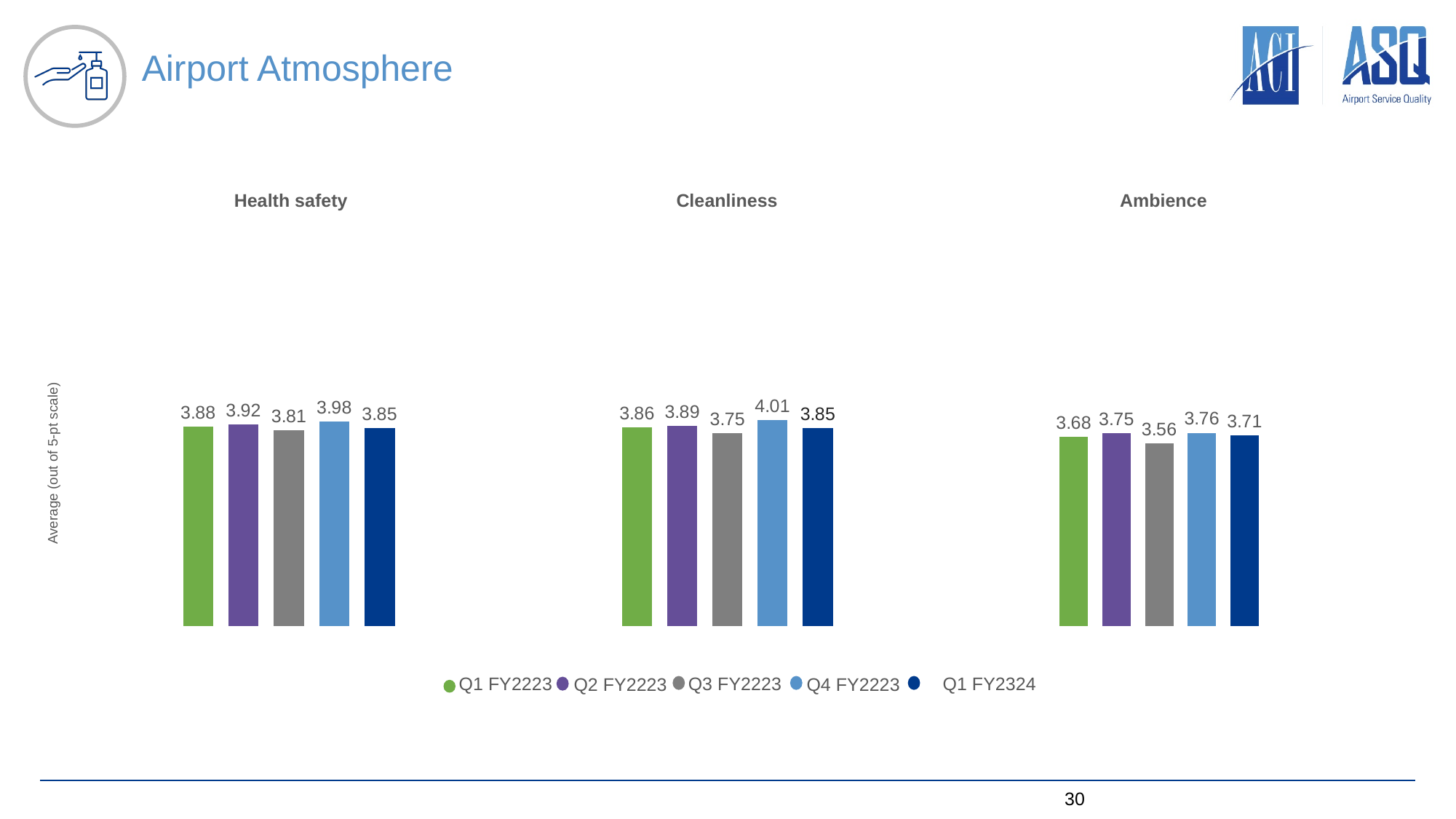
How many series does the legend list? 5 What is the Q4 FY2223 value for Cleanliness? 4.01 What is the Q3 FY2223 value for Health safety? 3.81 What is the difference between the Q2 FY2223 and Q1 FY2223 values for Ambience? 0.07 What is the difference between the Q4 FY2223 and Q3 FY2223 values for Cleanliness? 0.26 Which quarter has the lowest value for Ambience? Q3 FY2223 Which quarter has the highest value for Health safety? Q4 FY2223 Which is larger for Q1 FY2324: Health safety or Ambience? Health safety What kind of chart is shown on the slide? Bar chart What is the Q1 FY2324 value for Ambience? 3.71 How many categories are shown on the chart? 3 What is the label of the vertical axis? Average (out of 5-pt scale)